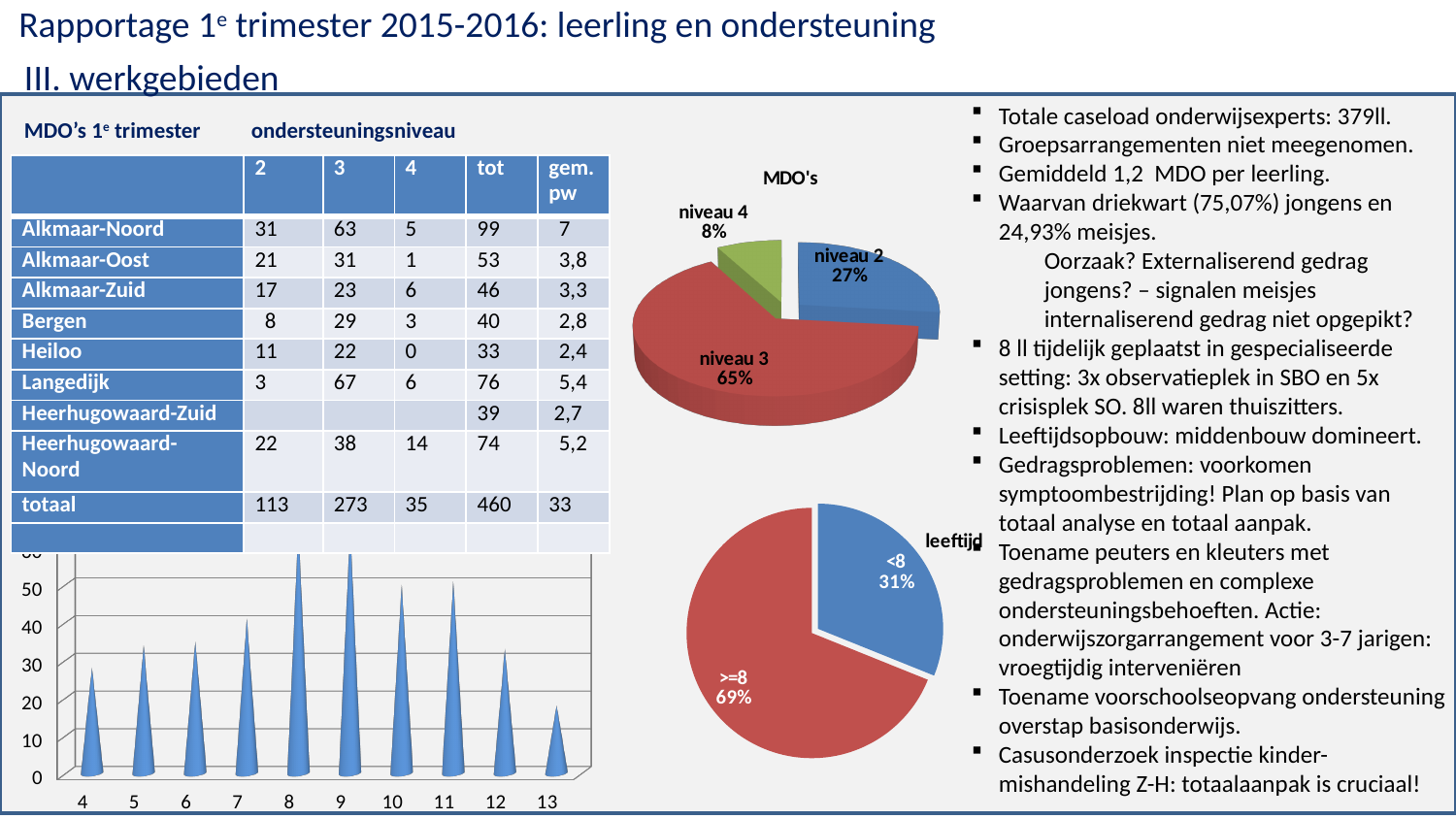
In the MDO's pie chart, what is the difference in percentage points between niveau 3 and niveau 2? 38 In the leeftijd pie chart, what percentage is shown for <8? 31% In the bottom-left bar chart, is the value for category 10 greater or less than 40? greater How many slices does the MDO's pie chart have? 3 How many categories are shown on the x axis of the bottom-left bar chart? 10 In the MDO's pie chart, what percentage is shown for niveau 2? 27% In the leeftijd pie chart, which slice is larger, <8 or >=8? >=8 In the bottom-left bar chart, is the value for category 13 greater or less than 30? less What kind of chart is the chart at the bottom left of the slide with categories 4 to 13? bar chart In the MDO's pie chart, what percentage is shown for niveau 3? 65% In the MDO's pie chart, which niveau has the smallest slice? niveau 4 In the leeftijd pie chart, what is the difference in percentage points between >=8 and <8? 38